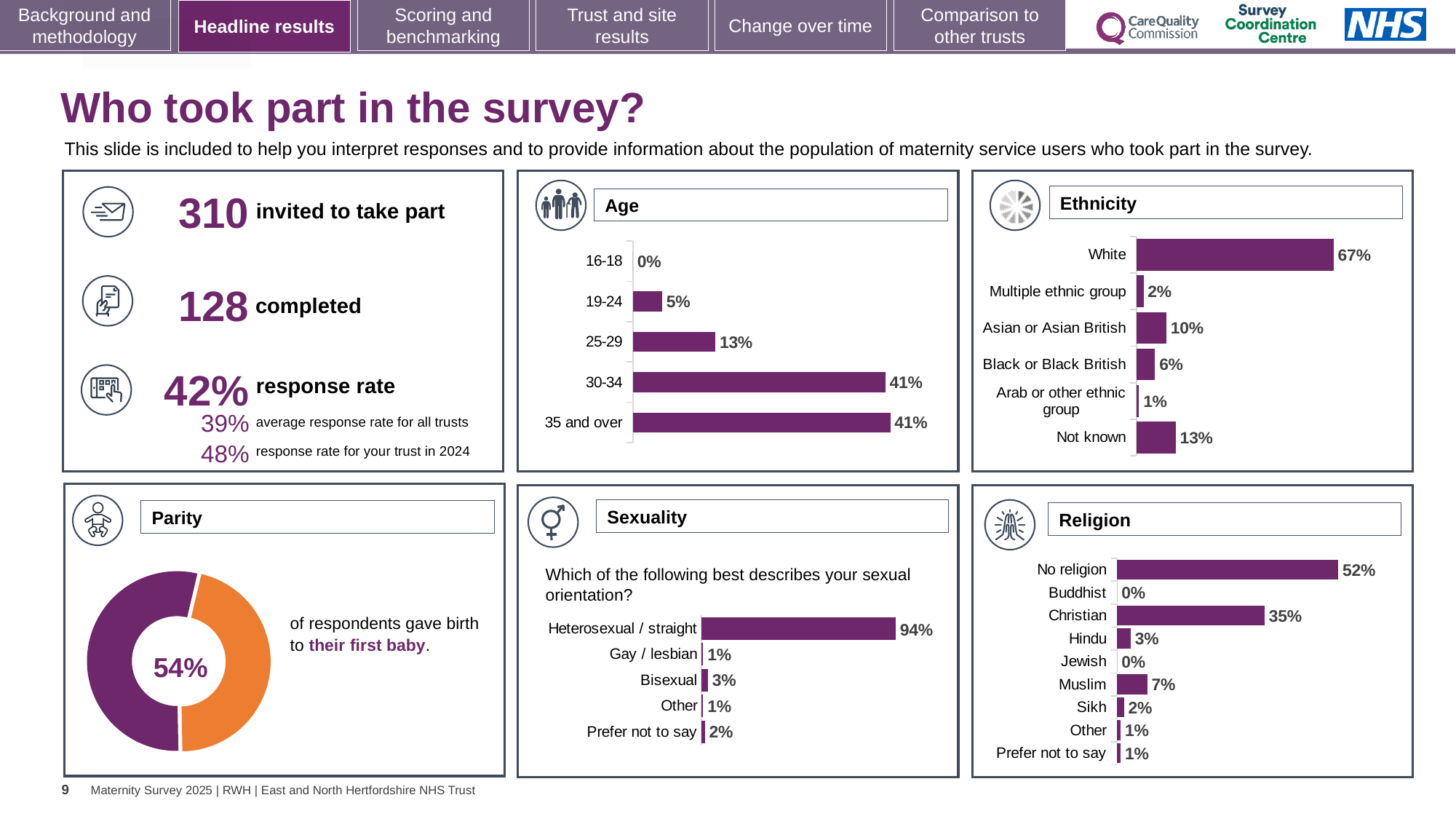
In the Ethnicity chart, which category has the highest value? White In the Sexuality chart, what percentage of respondents answered Heterosexual / straight? 94% In the Religion chart, how many categories are shown? 9 In the Age chart, how many age categories are shown? 5 In the Age chart, what percentage of respondents were aged 25-29? 13% In the Religion chart, which category has the highest value? No religion In the Ethnicity chart, what percentage is shown for Not known? 13% In the Ethnicity chart, what is the difference between the values for Asian or Asian British and Black or Black British? 4% What kind of chart is the Parity chart? Donut (pie) chart In the Parity chart, what share of respondents gave birth to their first baby? 54% In the Religion chart, what is the difference between the values for No religion and Christian? 17% In the Sexuality chart, which is larger, the value for Bisexual or the value for Prefer not to say? Bisexual